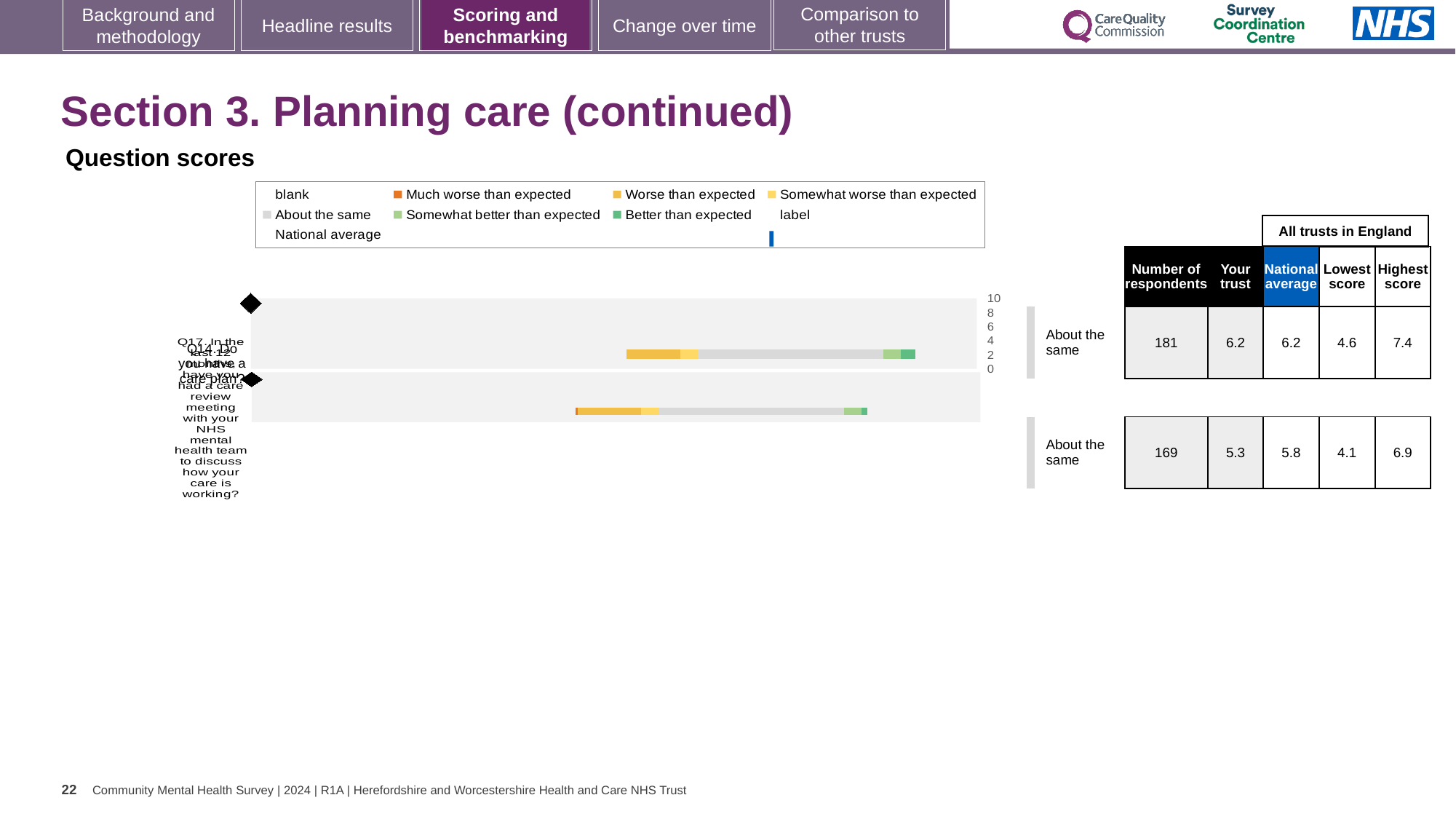
What is the maximum value shown on the chart's numeric axis? 10 What kind of chart is shown under 'Question scores'? Bar chart In the table beside the chart, how many respondents are listed for Q17 (care review meeting)? 169 For Q17, how much lower is the 'Your trust' score (5.3) than the national average (5.8)? 0.5 What does the blue marker in the chart legend represent? National average How many questions (bars) are plotted in the chart? 2 In the table beside the chart, what is the national average for Q17? 5.8 What is the difference between the highest score (7.4) and the lowest score (4.6) for Q14 in the table? 2.8 What benchmark category is shown next to the chart for both Q14 and Q17? About the same In the table beside the chart, what is the 'Your trust' score for Q14 (Do you have a care plan?)? 6.2 What colour does the legend use for 'Better than expected'? Green Which question has the higher 'Your trust' score in the table, Q14 or Q17? Q14